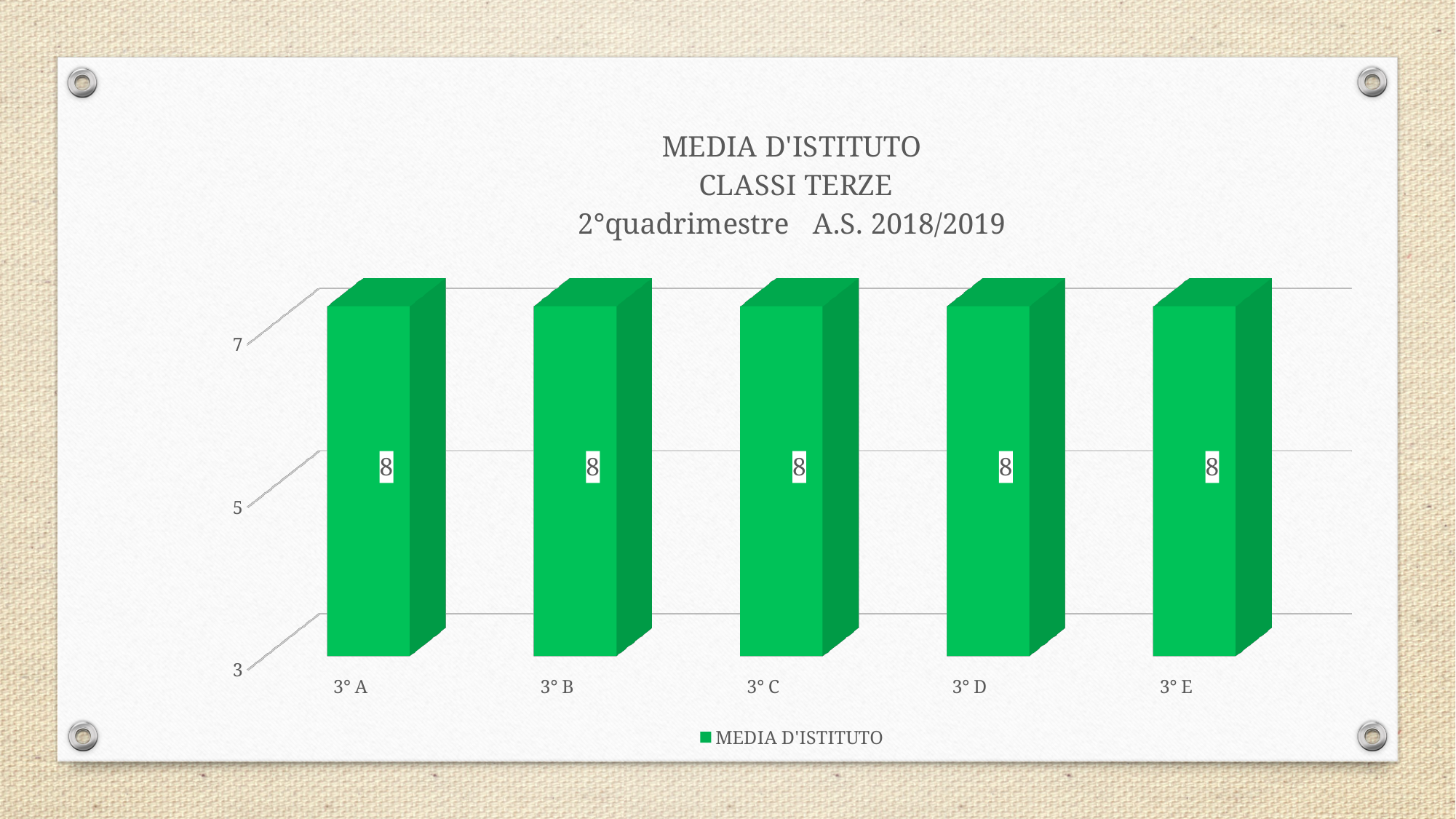
Which school year is named in the chart title? A.S. 2018/2019 What is the value for 3° A? 8 How many series does the legend list? 1 What is the difference between the values for 3° B and 3° D? 0 What is the value for 3° D? 8 How many classes are shown on the x axis? 5 What is the name of the series in the legend? MEDIA D'ISTITUTO Do the values rise, fall or stay the same from 3° A to 3° E? stay the same Is the value for 3° B greater or less than 7? greater What is the value for 3° E? 8 What kind of chart is shown on the slide? bar chart What is the value for 3° C? 8